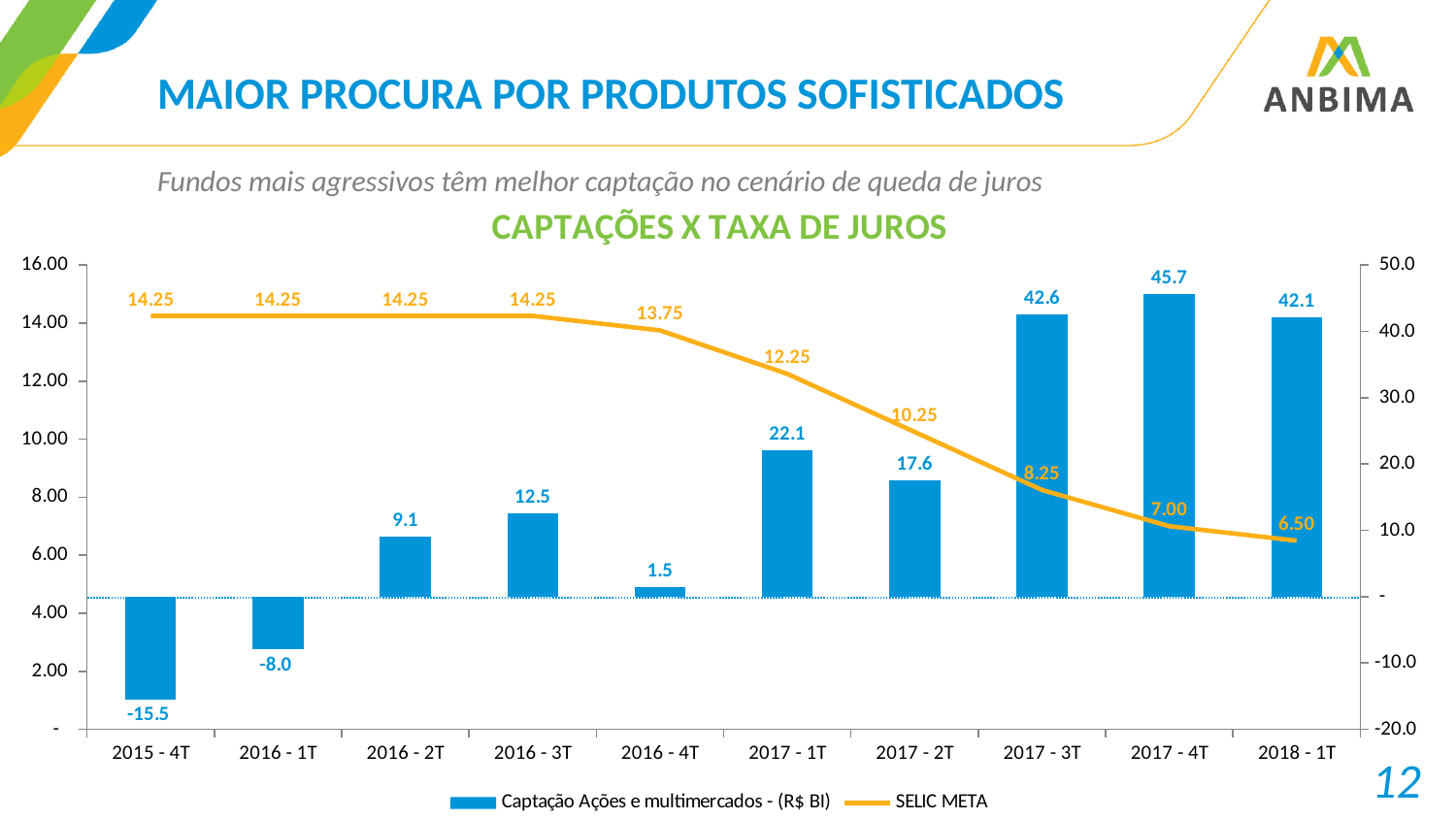
Which is larger, the Captação value for 2017 - 1T or for 2017 - 2T? 2017 - 1T How many series does the legend list? 2 What is the value of Captação Ações e multimercados for 2017 - 3T? 42.6 What is the difference between the Captação values for 2017 - 4T and 2017 - 3T? 3.1 What is the difference between the SELIC META values for 2017 - 1T and 2017 - 2T? 2.00 Which period has the highest Captação Ações e multimercados value? 2017 - 4T Which period has the lowest Captação Ações e multimercados value? 2015 - 4T What is the SELIC META value for 2016 - 4T? 13.75 What is the SELIC META value for 2018 - 1T? 6.50 How many periods are shown on the x axis? 10 What is the value of Captação Ações e multimercados for 2015 - 4T? -15.5 Does the SELIC META line rise or fall from 2016 - 4T to 2018 - 1T? fall